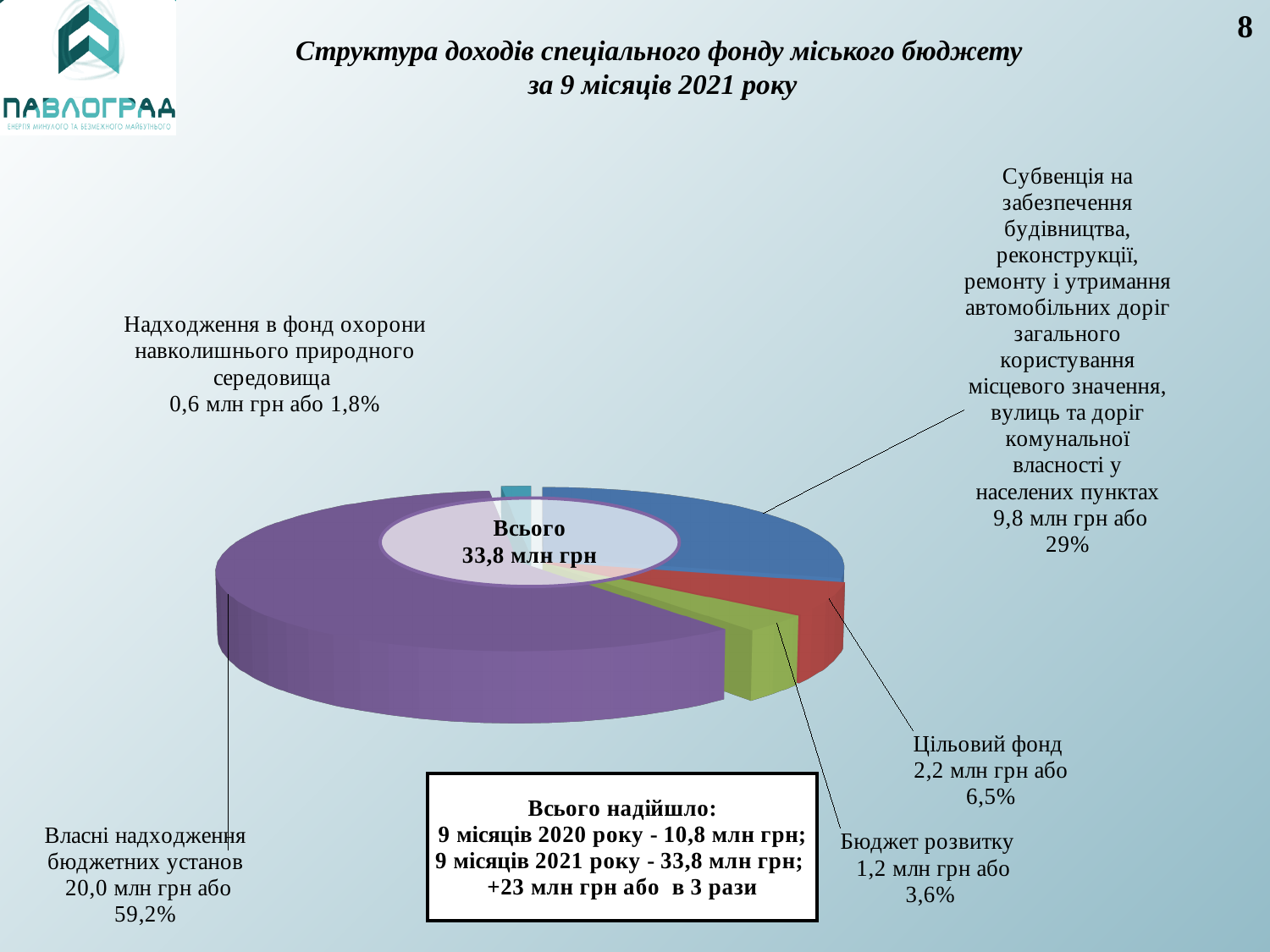
What share of the pie does "Бюджет розвитку" represent? 3,6% What kind of chart is shown on the slide? pie chart Which is larger: "Бюджет розвитку" or "Надходження в фонд охорони навколишнього природного середовища"? Бюджет розвитку How many slices does the pie chart have? 5 What is the difference in млн грн between "Цільовий фонд" and "Бюджет розвитку"? 1,0 млн грн Which category has the largest slice of the pie? Власні надходження бюджетних установ What share of the pie does "Власні надходження бюджетних установ" represent? 59,2% What is the total value shown in the centre of the pie chart? 33,8 млн грн What share of the pie does the subvention for roads ("Субвенція на забезпечення будівництва, реконструкції, ремонту і утримання автомобільних доріг...") represent? 29% What is the value shown for "Цільовий фонд"? 2,2 млн грн What is the value shown for "Власні надходження бюджетних установ"? 20,0 млн грн Which category has the smallest slice of the pie? Надходження в фонд охорони навколишнього природного середовища